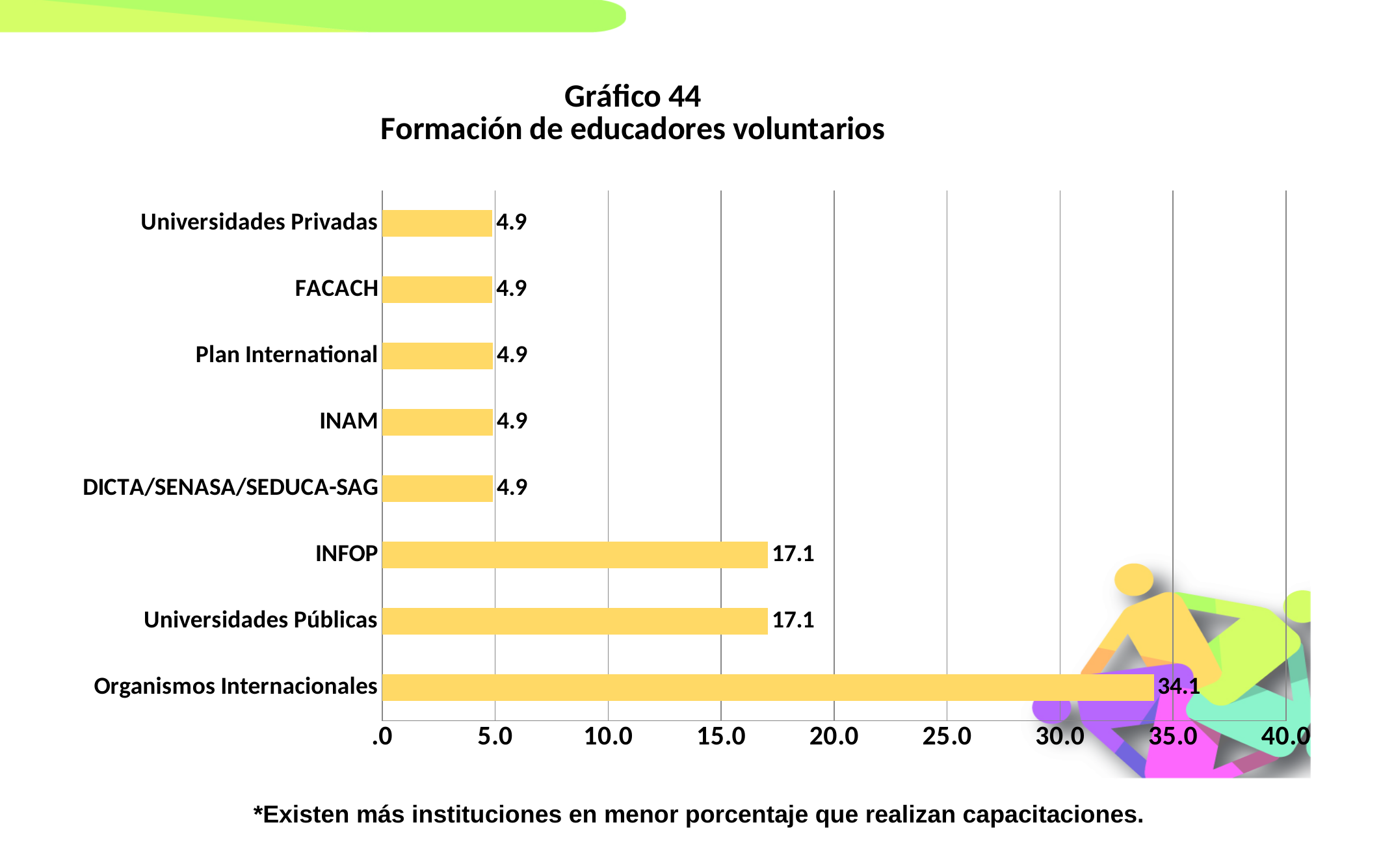
What is the value for Organismos Internacionales? 34.1 What is the value for FACACH? 4.9 What is the title of the chart? Gráfico 44 Formación de educadores voluntarios How many categories have a value of 4.9? 5 Which category has the highest value? Organismos Internacionales What is the value for INFOP? 17.1 Which is larger, the value for Universidades Públicas or the value for Plan International? Universidades Públicas How many categories are shown in the chart? 8 What kind of chart is shown on the slide? bar chart What is the difference between the values for INFOP and INAM? 12.2 What is the difference between the values for Organismos Internacionales and Universidades Públicas? 17.0 Is the value for Organismos Internacionales greater or less than 30.0? greater